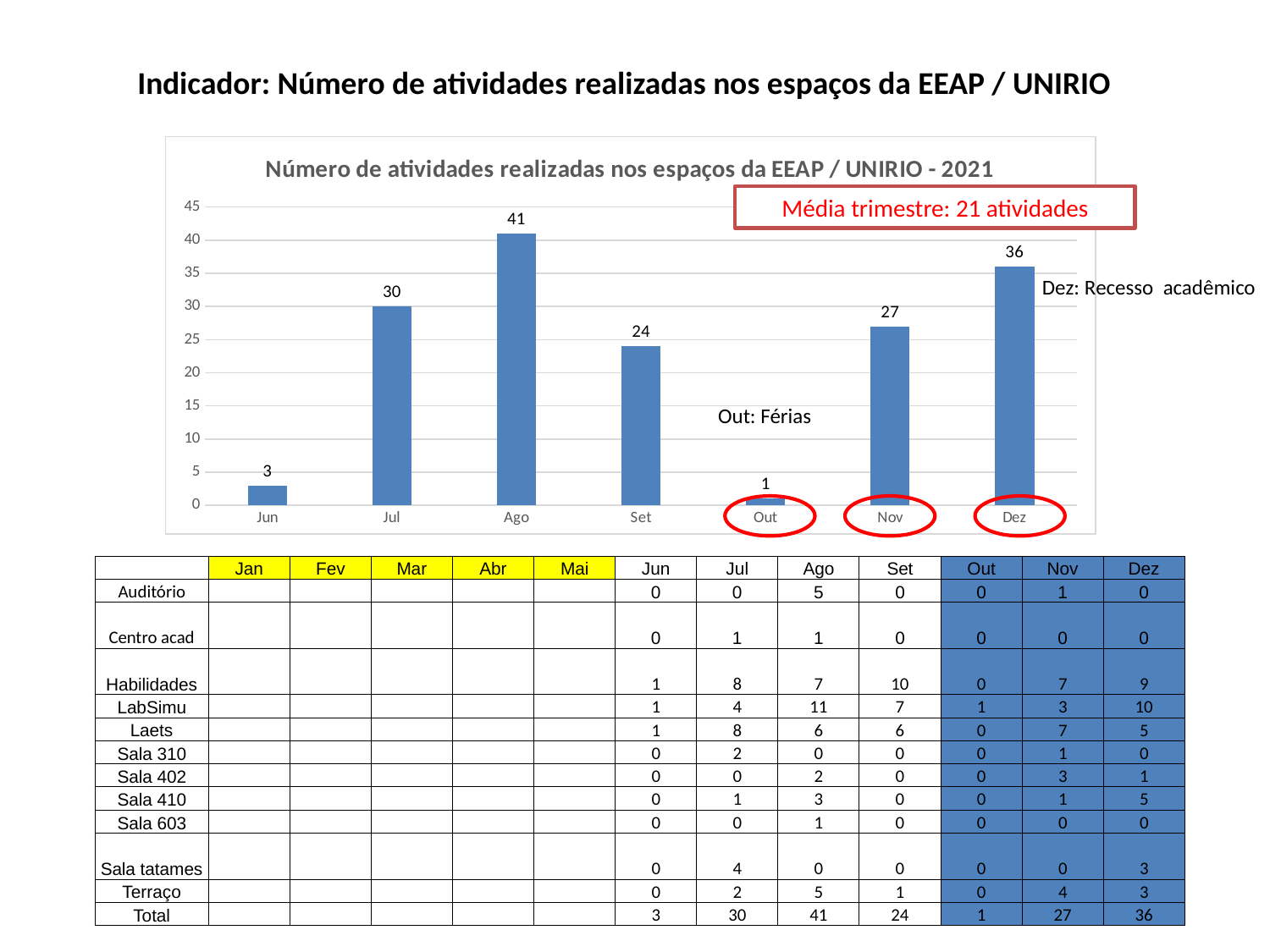
What is the value for Ago in the chart? 41 Which is larger, the value for Set or the value for Nov? Nov Is the value for Jul greater or less than 25? greater What kind of chart is shown on the slide? bar chart What is the value for Dez in the chart? 36 How many months are plotted in the chart? 7 What is the title of the chart? Número de atividades realizadas nos espaços da EEAP / UNIRIO - 2021 Which month has the highest number of activities in the chart? Ago What is the value for Out in the chart? 1 What is the difference between the values for Ago and Jul? 11 Which month has the lowest number of activities in the chart? Out What is the difference between the values for Dez and Nov? 9